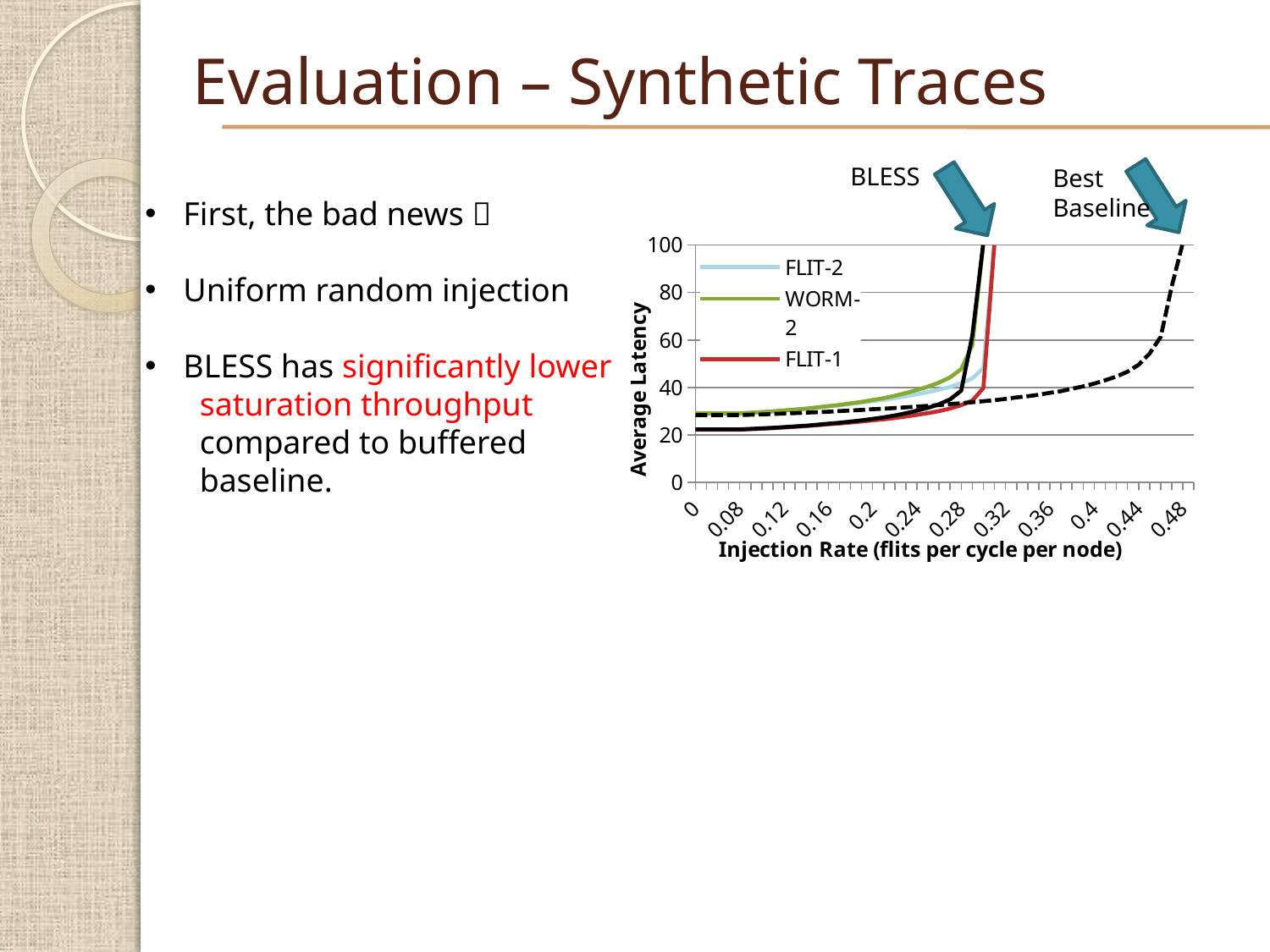
What is the highest value shown on the vertical axis of the chart? 100 Which curve reaches an average latency of 100 at the highest injection rate, BLESS or Best Baseline? Best Baseline What is the label of the chart's vertical axis? Average Latency Is the average latency of WORM-2 at an injection rate of 0.2 greater or less than 40? less Is the average latency of the Best Baseline (dashed line) at an injection rate of 0.4 greater or less than 60? less At an injection rate of 0.1, which has the higher average latency, WORM-2 or FLIT-1? WORM-2 What is the label of the chart's horizontal axis? Injection Rate (flits per cycle per node) Does average latency rise or fall as injection rate increases along the x axis? rise What is the largest injection rate labelled on the horizontal axis? 0.48 How many series does the chart's legend list? 3 Is the average latency of FLIT-1 at an injection rate of 0.1 greater or less than 40? less What kind of chart is shown on the slide? line chart